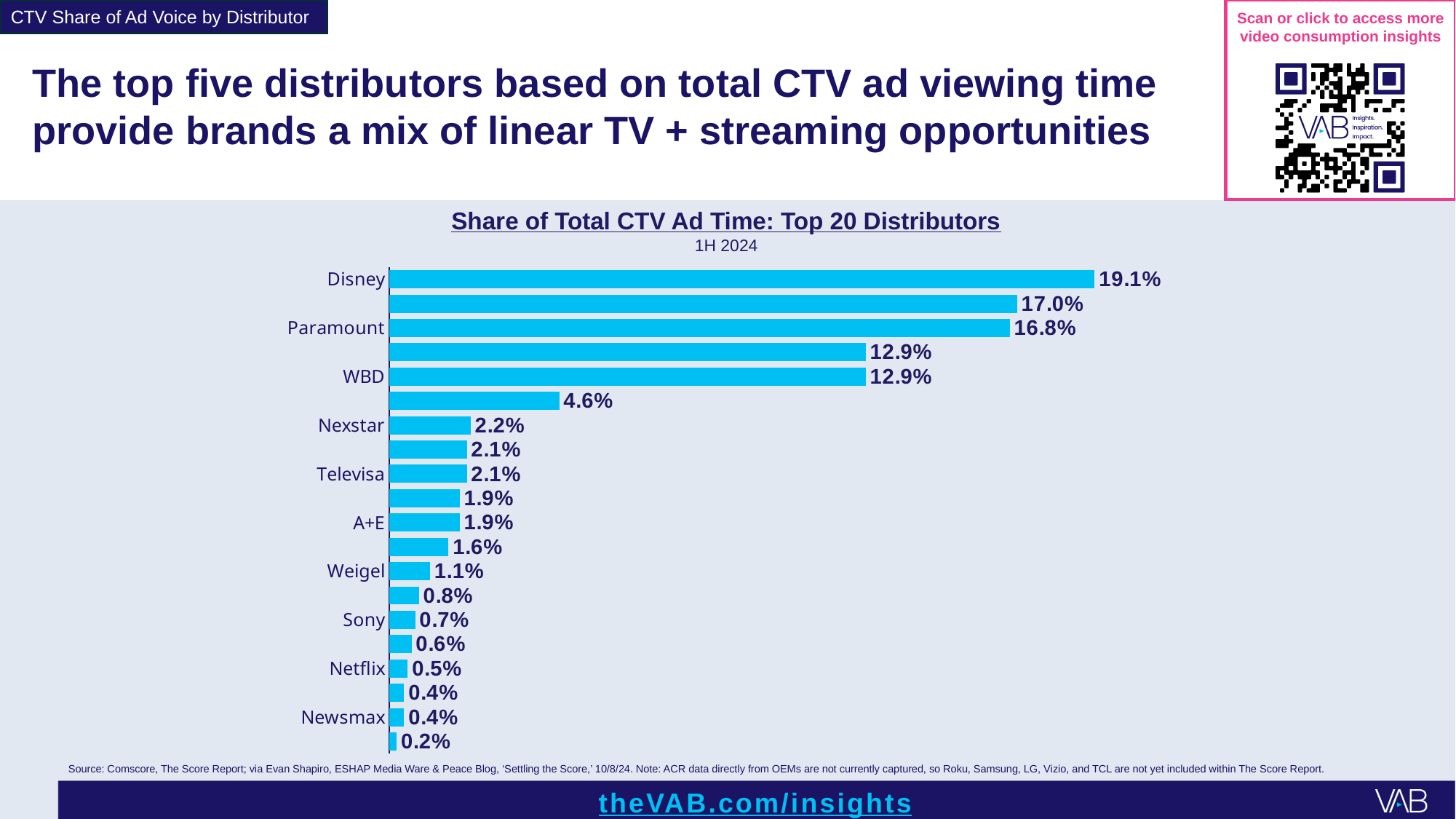
What is the share of total CTV ad time for Nexstar? 2.2% What is the share of total CTV ad time for Disney? 19.1% What kind of chart is shown on the slide? Bar chart What is the share of total CTV ad time for Paramount? 16.8% How many bars are plotted on the chart? 20 Which has a larger share of total CTV ad time, Sony or Netflix? Sony Which distributor has the highest share of total CTV ad time? Disney What is the smallest value shown on the chart? 0.2% What is the share of total CTV ad time for WBD? 12.9% What is the share of total CTV ad time for Netflix? 0.5% What is the difference between Paramount's share and WBD's share? 3.9% What is the difference between Disney's share and Paramount's share? 2.3%